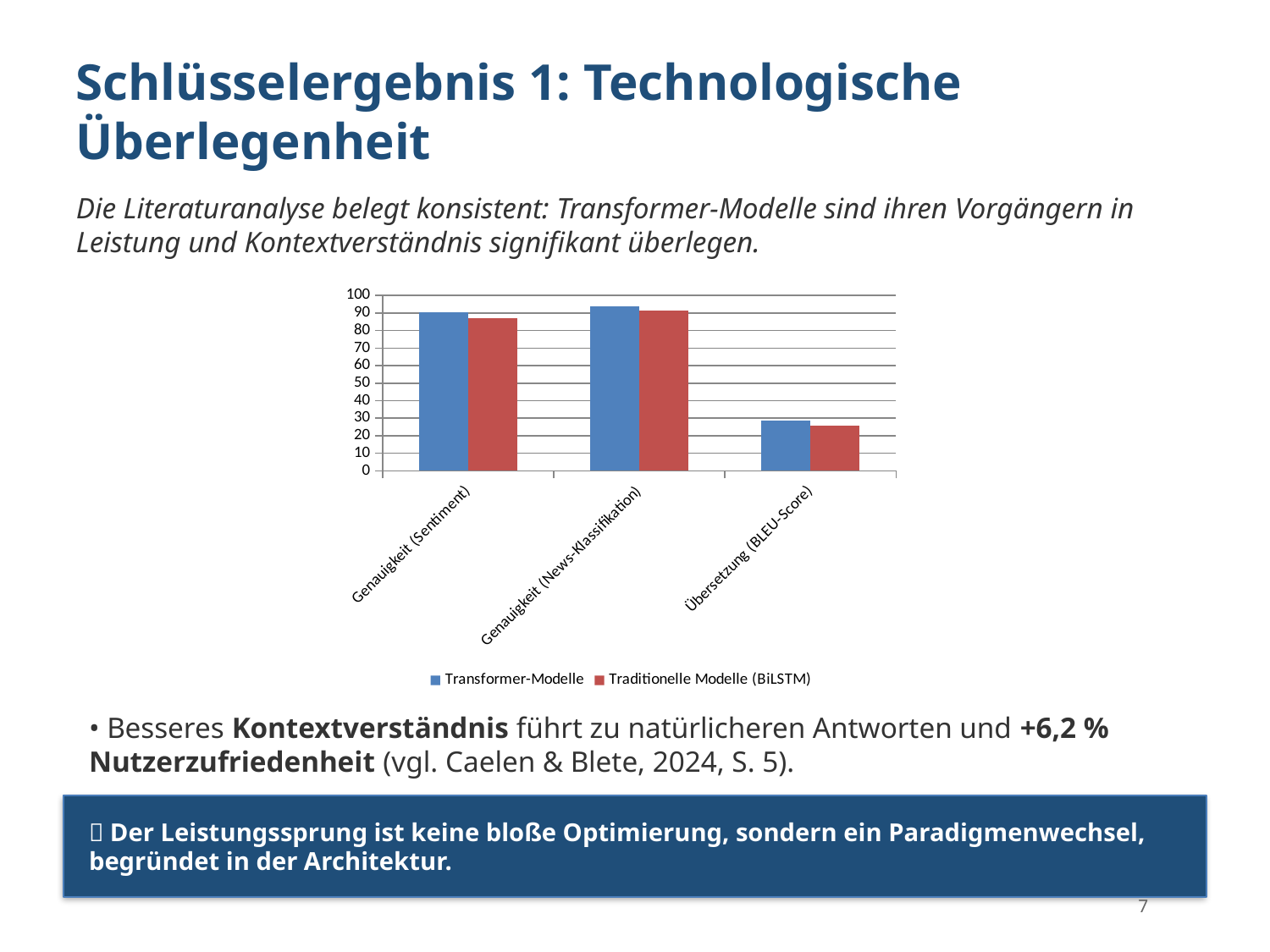
Which category has the lowest value for Traditionelle Modelle (BiLSTM)? Übersetzung (BLEU-Score) Is the value for Traditionelle Modelle (BiLSTM) in Genauigkeit (News-Klassifikation) greater or less than 80? greater For Transformer-Modelle, which is larger: the value for Genauigkeit (Sentiment) or the value for Übersetzung (BLEU-Score)? Genauigkeit (Sentiment) Is the value for Transformer-Modelle in Genauigkeit (Sentiment) greater or less than 80? greater What kind of chart is shown on the slide? bar chart Which series is shown in red in the chart? Traditionelle Modelle (BiLSTM) How many categories are shown on the x axis of the chart? 3 Which series is shown in blue in the chart? Transformer-Modelle Which category has the lowest value for Transformer-Modelle? Übersetzung (BLEU-Score) How many series does the chart's legend list? 2 Is the value for Transformer-Modelle in Übersetzung (BLEU-Score) greater or less than 50? less